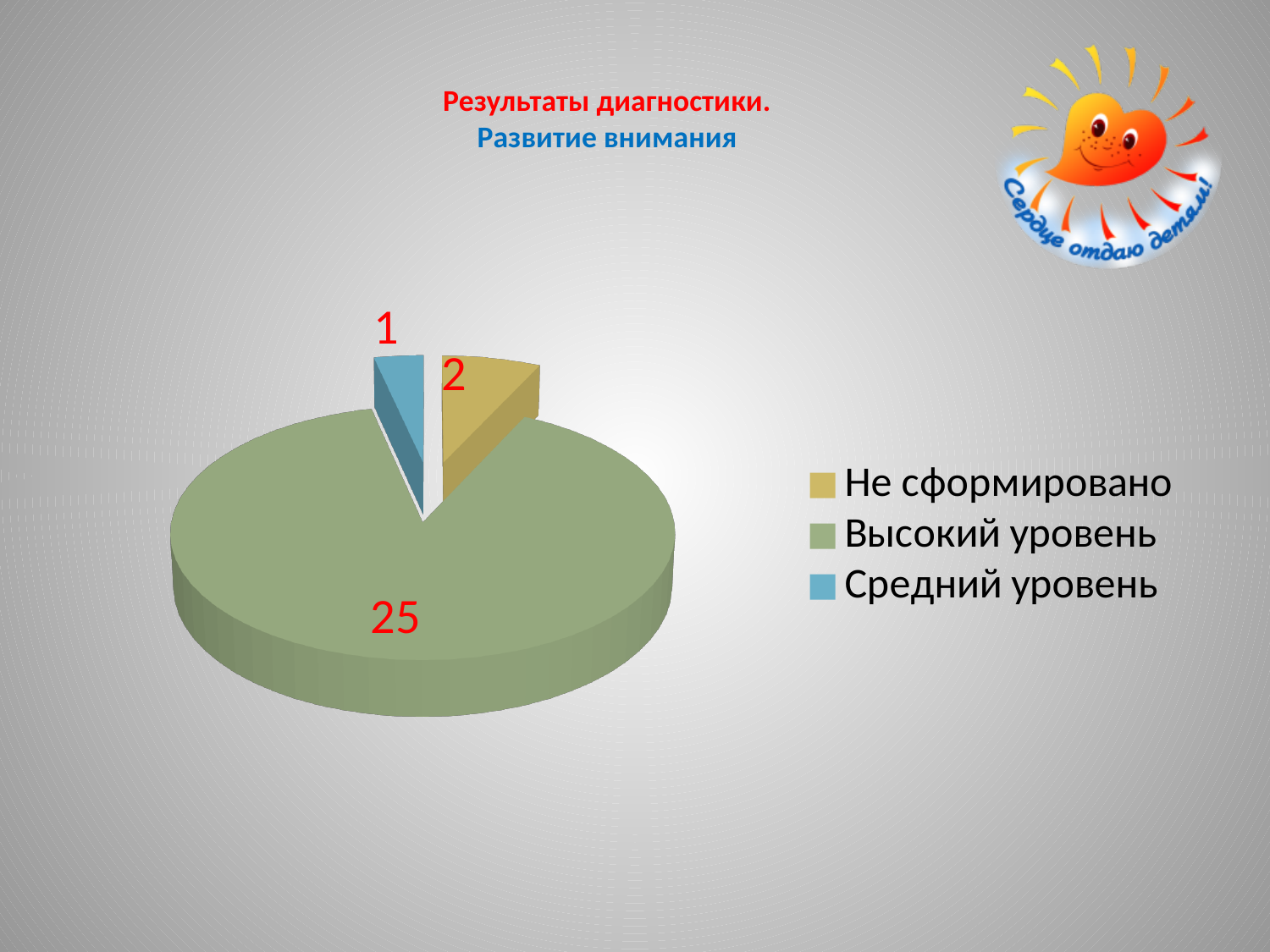
What is the value for Высокий уровень? 25 What colour is the slice for Средний уровень? Blue What is the total of all the slices in the pie chart? 28 What is the value for Не сформировано? 2 Which category has the largest slice of the pie? Высокий уровень What kind of chart is shown on the slide? Pie chart How many categories does the pie chart have? 3 Which is larger, the value for Не сформировано or the value for Средний уровень? Не сформировано What is the difference between the values for Не сформировано and Средний уровень? 1 What is the difference between the values for Высокий уровень and Не сформировано? 23 What is the value for Средний уровень? 1 Which category has the smallest slice of the pie? Средний уровень